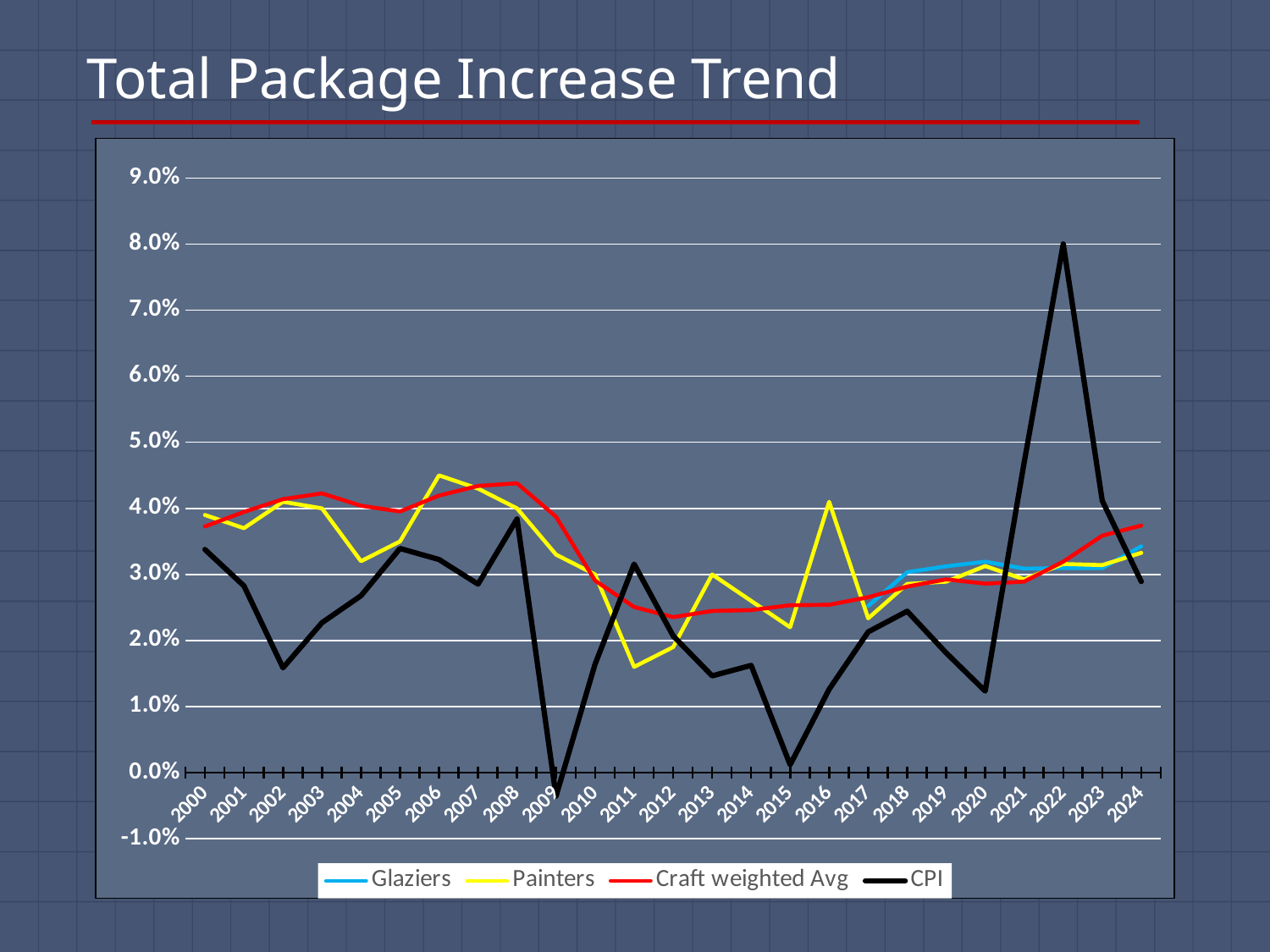
In which year does the CPI line reach its lowest value? 2009 Does the CPI line rise or fall from 2020 to 2022? rise Is the CPI value for 2009 greater or less than 0.0%? less How many years are shown along the x axis? 25 In which year does the CPI line reach its highest value? 2022 Is the Craft weighted Avg value for 2012 greater or less than 3.0%? less Is the CPI value for 2022 greater or less than 7.0%? greater What is the title of the chart? Total Package Increase Trend What kind of chart is shown on the slide? line chart In 2022, which is larger: the CPI value or the Painters value? CPI How many series does the legend list? 4